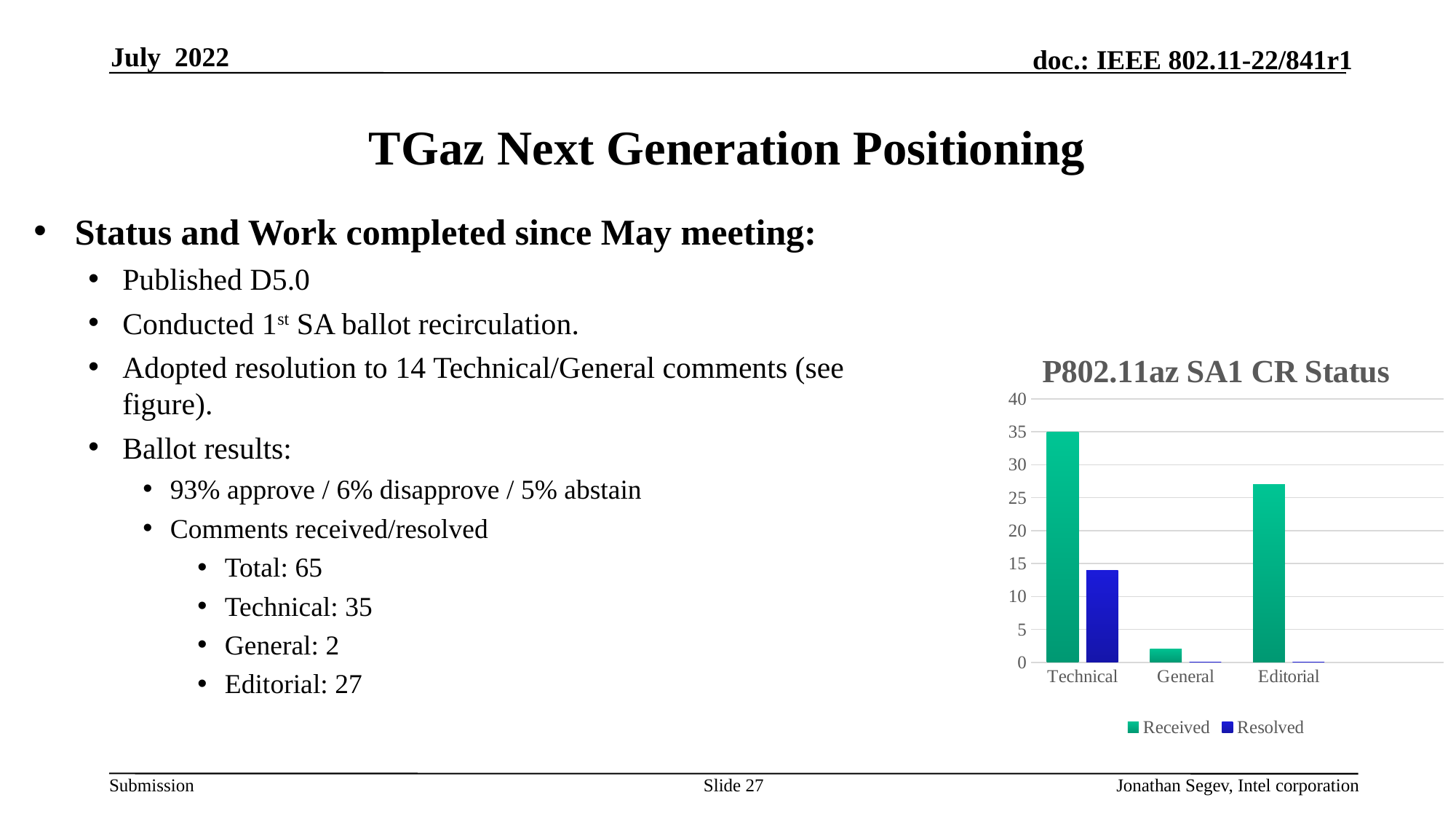
What are the two legend entries in the P802.11az SA1 CR Status chart? Received and Resolved In the P802.11az SA1 CR Status chart, for Technical, which is larger: Received or Resolved? Received In the P802.11az SA1 CR Status chart, which category has the highest Received value? Technical In the P802.11az SA1 CR Status chart, is the Received value for Editorial greater or less than 25? greater In the P802.11az SA1 CR Status chart, which has the larger Received value: Editorial or General? Editorial In the P802.11az SA1 CR Status chart, is the Received value for General greater or less than 5? less In the P802.11az SA1 CR Status chart, is the Resolved value for Technical greater or less than 10? greater What kind of chart is the P802.11az SA1 CR Status chart? bar chart In the P802.11az SA1 CR Status chart, which category has the lowest Received value? General How many categories are shown on the x axis of the P802.11az SA1 CR Status chart? 3 In the P802.11az SA1 CR Status chart, what is the Received value for Technical? 35 How many series does the legend of the P802.11az SA1 CR Status chart list? 2